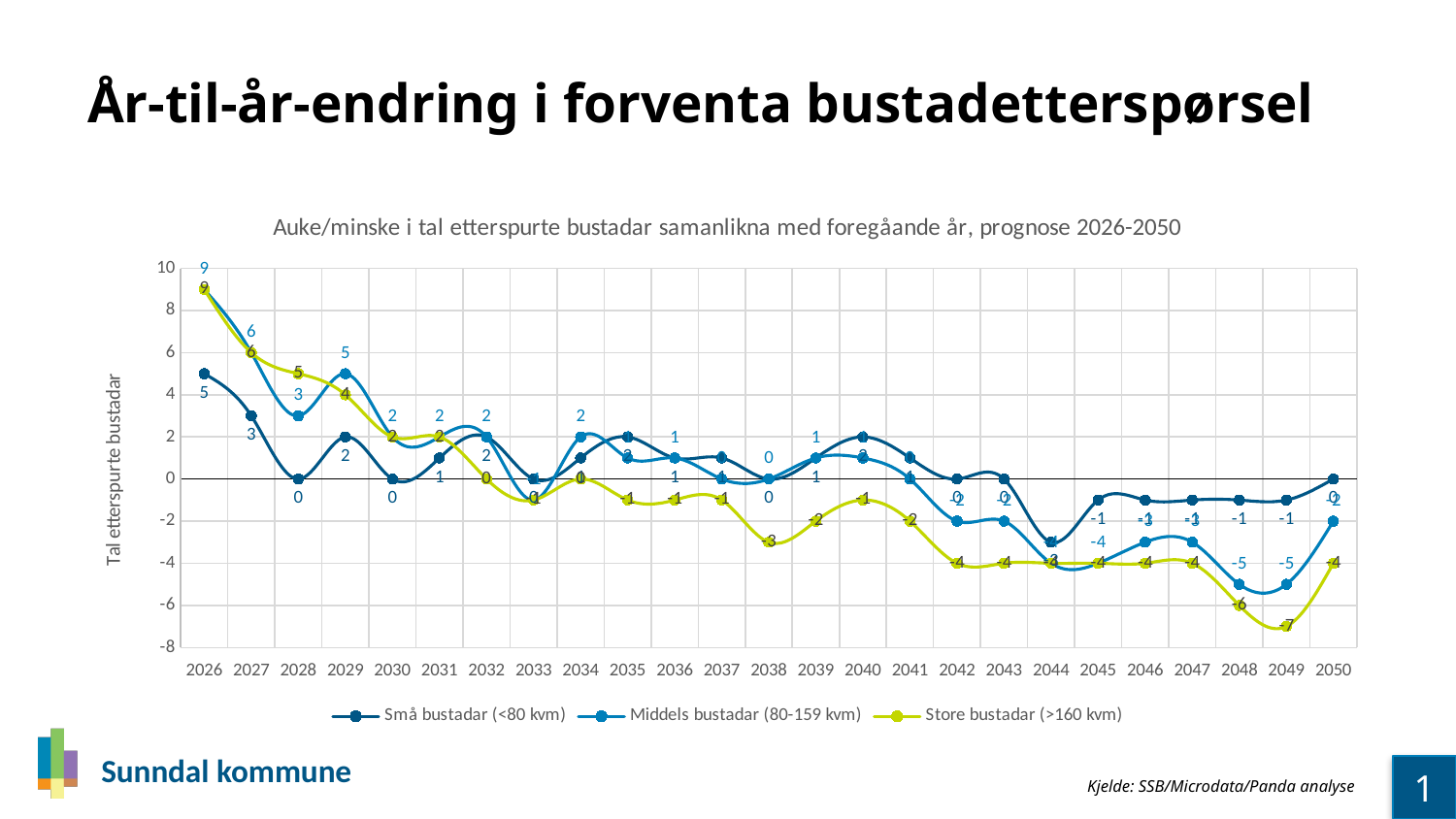
What kind of chart is shown on the slide? Line chart How many series does the legend list? 3 Does the Store bustadar (>160 kvm) series generally rise or fall from 2026 to 2049? Fall In which year does Store bustadar (>160 kvm) reach its lowest value? 2049 What is the difference between the Middels bustadar (80-159 kvm) value and the Små bustadar (<80 kvm) value in 2026? 4 What is the value for Små bustadar (<80 kvm) in 2027? 3 What is the value for Store bustadar (>160 kvm) in 2049? -7 In which year does Middels bustadar (80-159 kvm) reach its highest value? 2026 How many years are plotted along the x axis? 25 In 2048, which series has the higher value: Små bustadar (<80 kvm) or Store bustadar (>160 kvm)? Små bustadar (<80 kvm) What is the value for Middels bustadar (80-159 kvm) in 2026? 9 What is the value for Middels bustadar (80-159 kvm) in 2029? 5